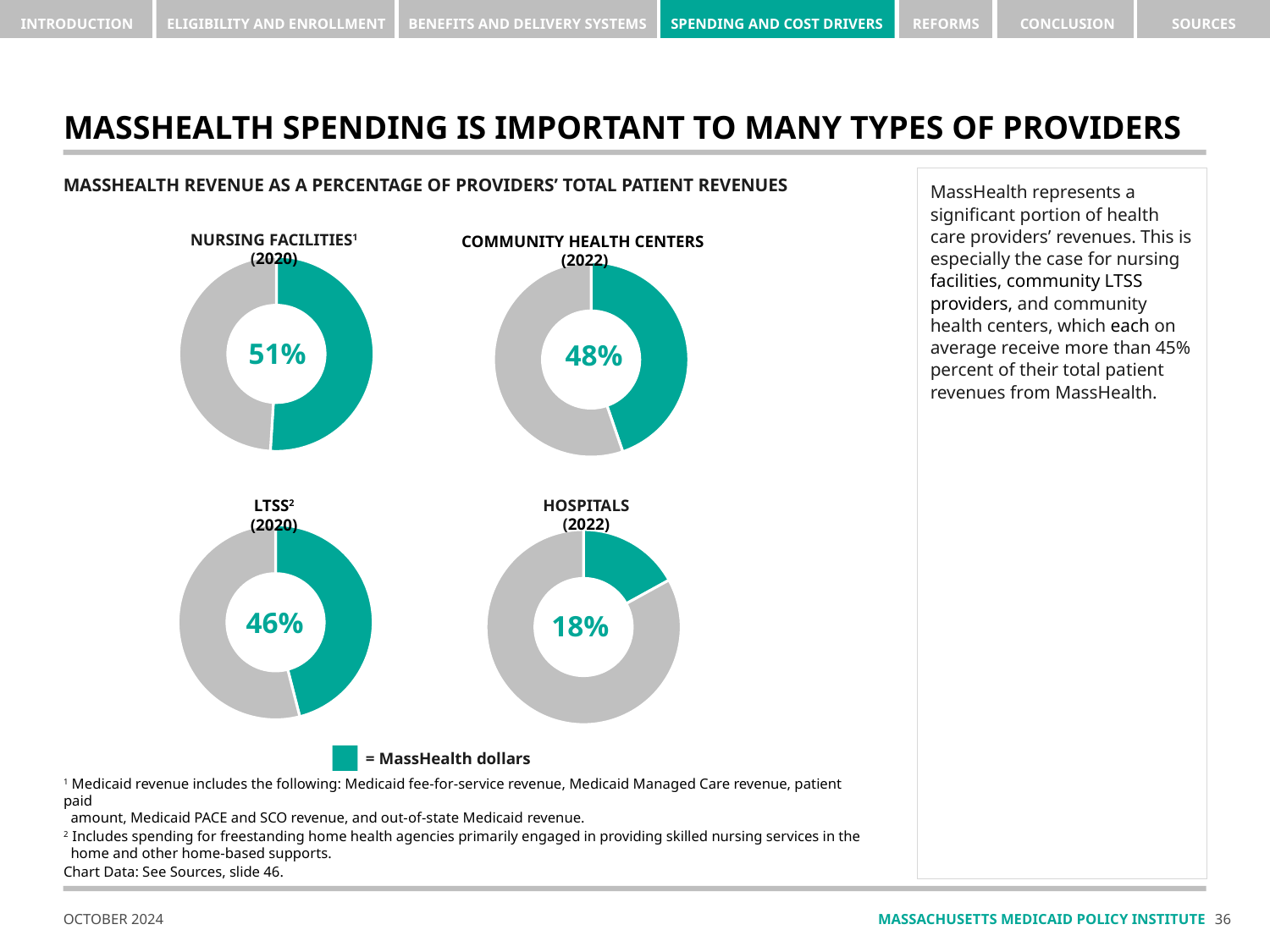
What type of chart is used to show MassHealth revenue as a percentage of providers' total patient revenues? Donut (pie) chart In the Community Health Centers (2022) donut chart, what share of revenue is MassHealth dollars? 48% How many donut charts are shown on the slide? 4 What is the difference in percentage points between the Nursing Facilities (2020) chart and the Hospitals (2022) chart? 33 percentage points Across the four donut charts on the slide, which provider type has the highest MassHealth share of revenue? Nursing Facilities In the Hospitals (2022) donut chart, what percentage of total patient revenues is MassHealth revenue? 18% In the Hospitals (2022) donut chart, what share of the ring is not MassHealth dollars? 82% Across the four donut charts on the slide, which provider type has the lowest MassHealth share of revenue? Hospitals In the LTSS (2020) donut chart, what percentage is shown for MassHealth dollars? 46% According to the legend below the charts, what does the teal colour represent? MassHealth dollars Comparing the Community Health Centers (2022) chart and the LTSS (2020) chart, which shows a larger MassHealth share? Community Health Centers In the Nursing Facilities (2020) donut chart, what percentage of total patient revenues comes from MassHealth? 51%